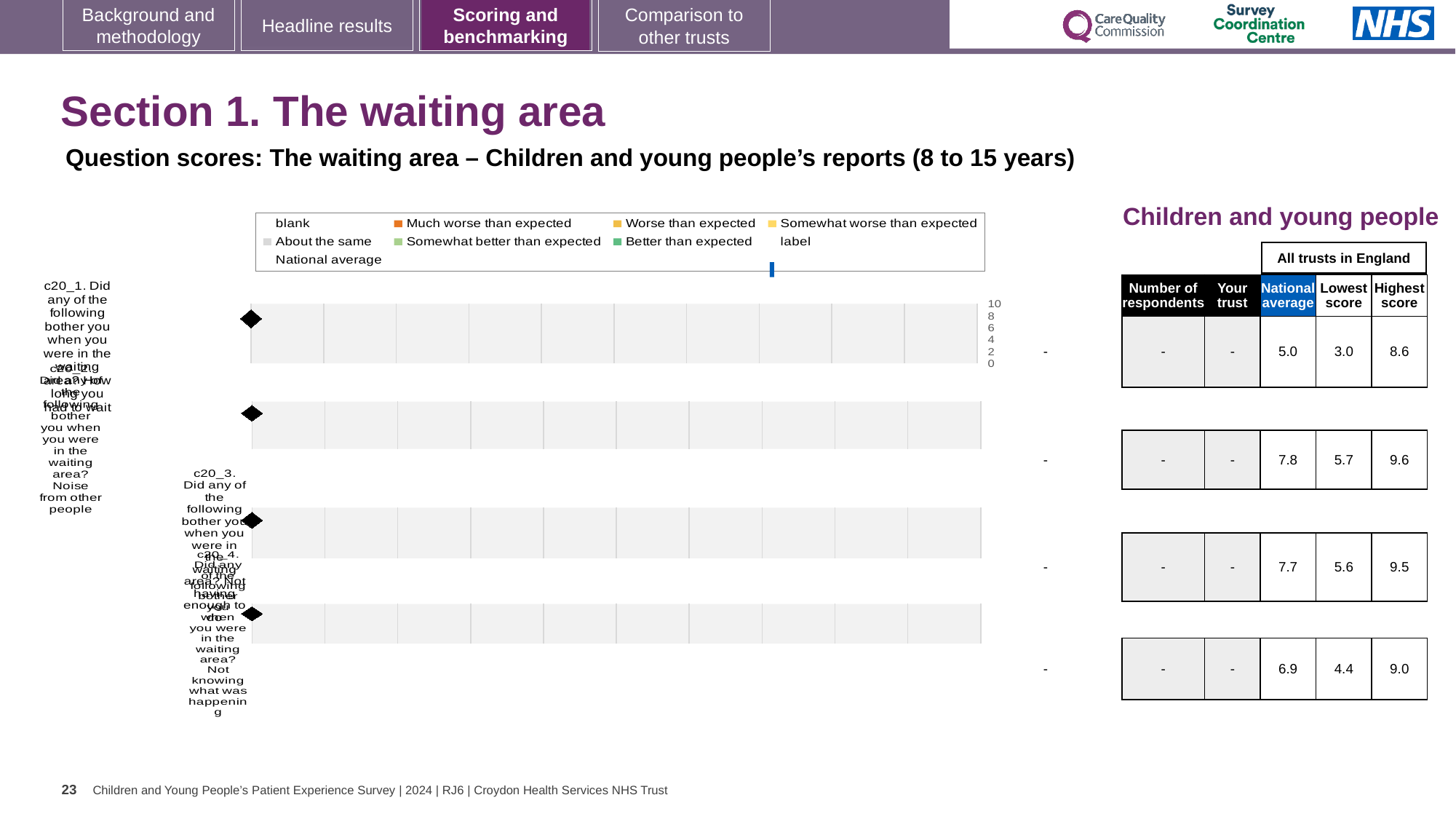
How many question rows (categories) does the chart have? 4 In the table to the right of the chart, what is the difference between the highest score and the lowest score for the first row (c20_1)? 5.6 In the table to the right of the chart, what is the lowest score for the third row (c20_3)? 5.6 In the table to the right of the chart, is the national average for the second row (c20_2) larger or smaller than that for the third row (c20_3)? larger In the table to the right of the chart, what is the national average for the fourth row (c20_4)? 6.9 What is the highest value shown on the chart's axis? 10 In the table to the right of the chart, which row has the lowest national average? c20_1 In the table to the right of the chart, what is the highest score for the second row (c20_2)? 9.6 In the table to the right of the chart, what is the national average for the first row (c20_1)? 5.0 In the table to the right of the chart, which row has the highest national average? c20_2 What kind of chart is shown on the slide? bar chart